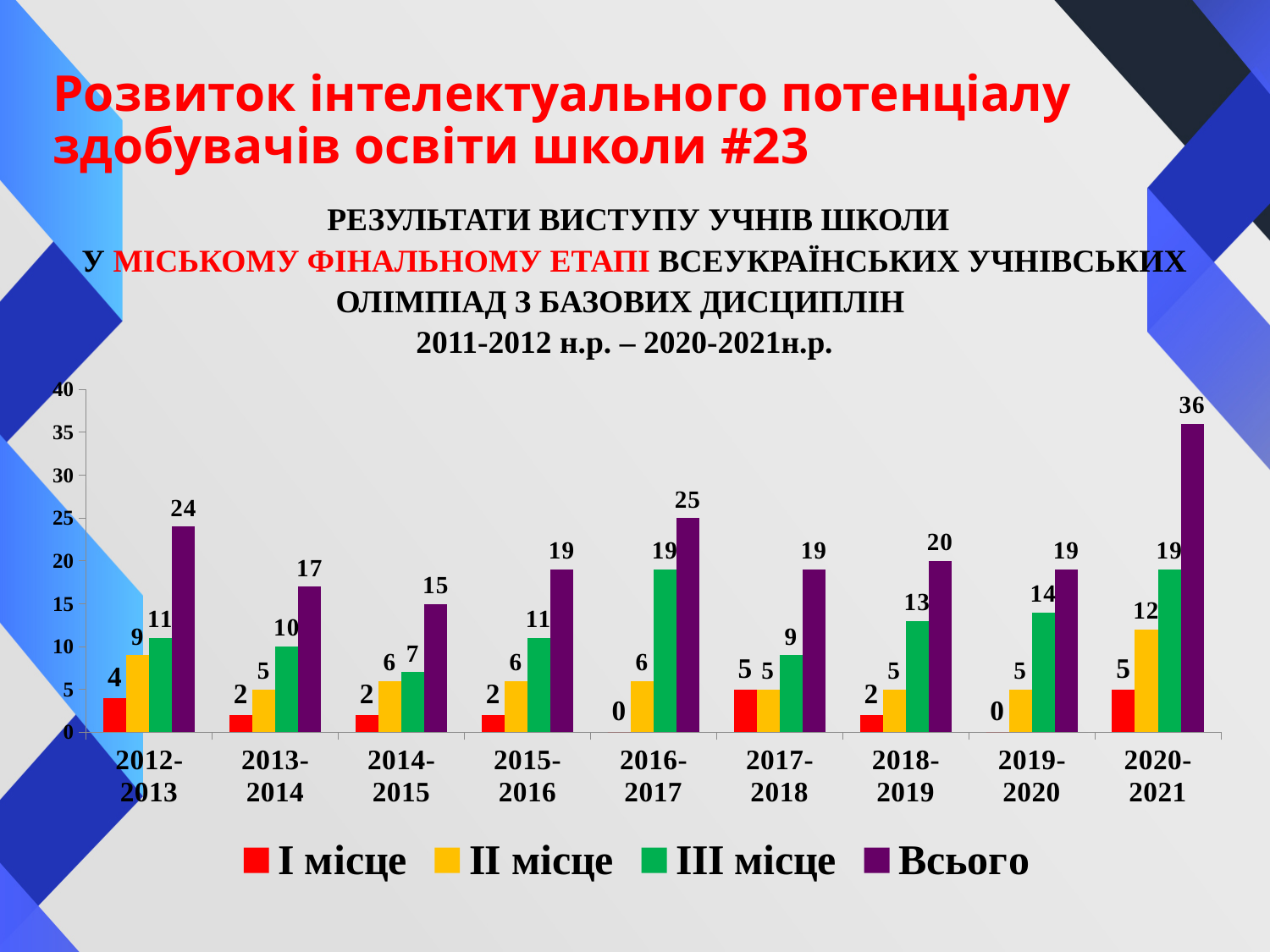
What is the difference between III місце and II місце for 2018-2019? 8 What is the difference between Всього for 2020-2021 and Всього for 2012-2013? 12 What is the value of Всього for 2020-2021? 36 In which school year is Всього the lowest? 2014-2015 In which school year is Всього the highest? 2020-2021 What is the value of I місце for 2019-2020? 0 Which is larger: II місце for 2020-2021 or II місце for 2012-2013? II місце for 2020-2021 How many school-year categories are shown on the x axis? 9 What is the value of III місце for 2016-2017? 19 Which series is shown in purple in the legend? Всього What kind of chart is shown on the slide? bar chart How many series does the legend list? 4